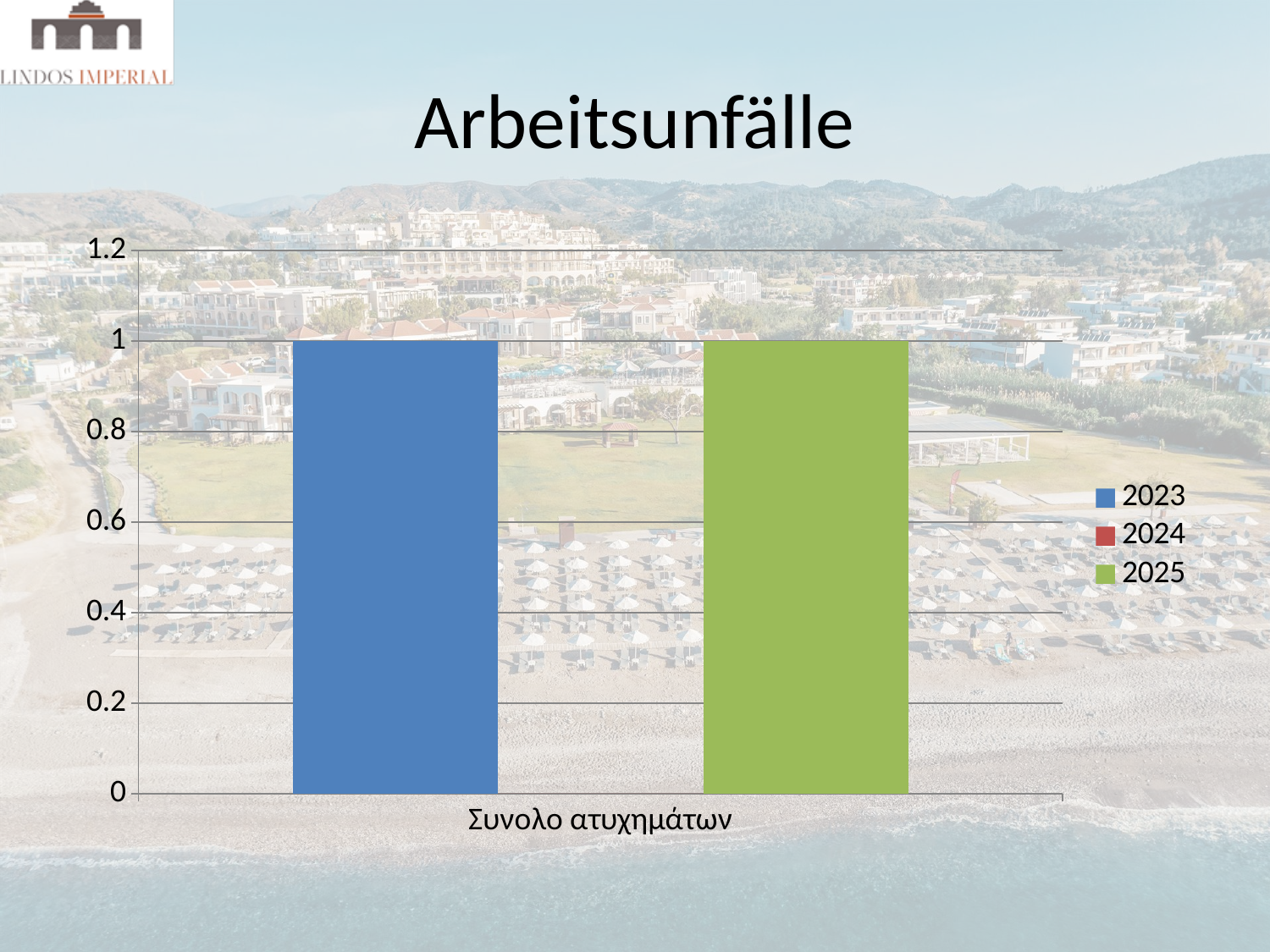
Which series has the lowest value in the chart? 2024 How many series does the legend list? 3 What is the value for 2025 in the Συνολο ατυχημάτων category? 1 Is the value for 2023 greater or less than 0.6? greater How many categories are shown on the x axis? 1 What kind of chart is shown on the slide? bar chart What is the difference between the values for 2023 and 2025? 0 What is the title of the chart? Arbeitsunfälle Which entries are listed in the legend? 2023, 2024, 2025 What is the value for 2023 in the Συνολο ατυχημάτων category? 1 Is the value for 2025 greater or less than 0.8? greater